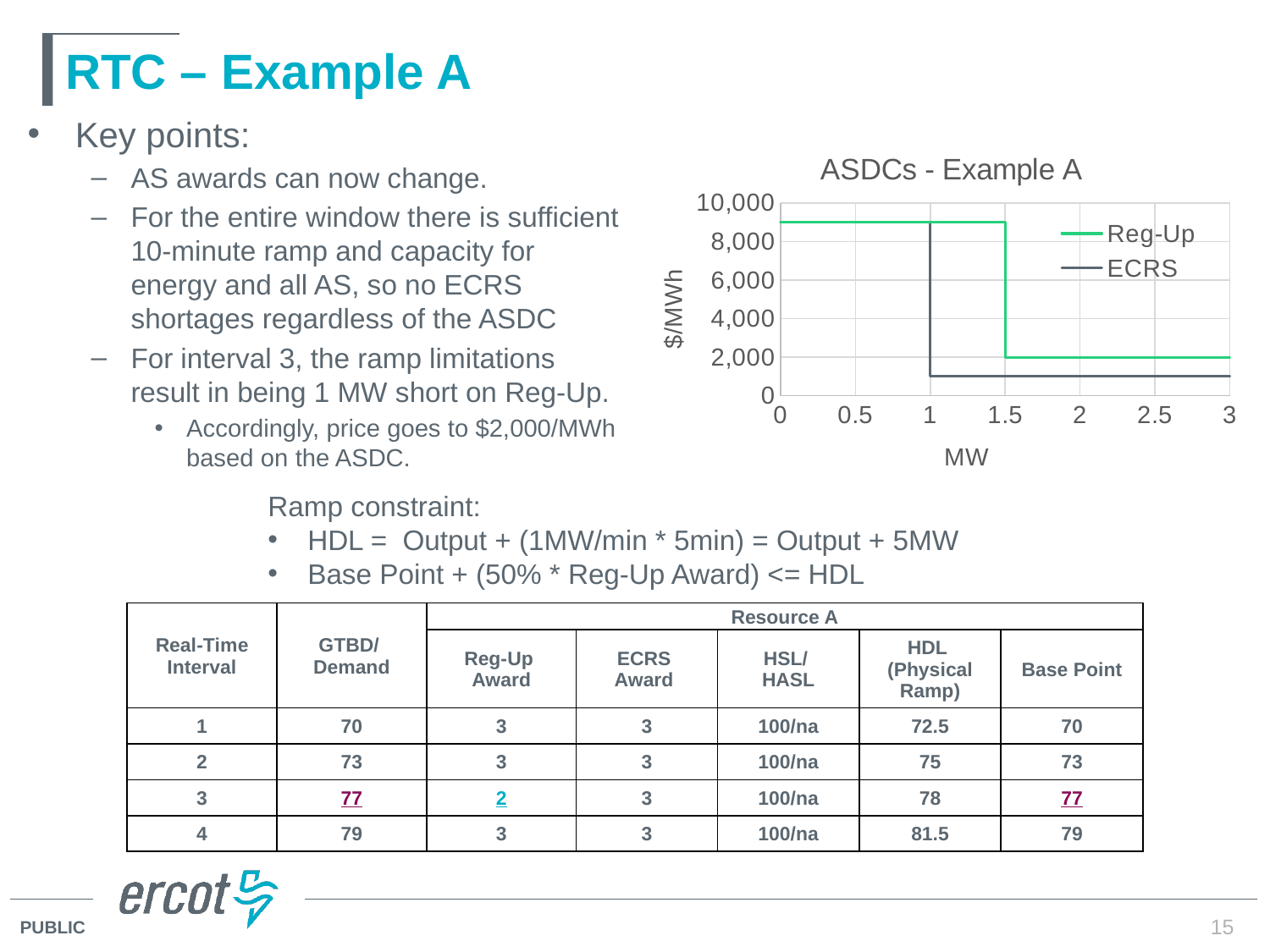
What is the Reg-Up value in $/MWh at 2 MW? 2,000 How many series does the legend of the chart list? 2 Is the ECRS value at 0.5 MW greater or less than 8,000? greater What is the title of the chart? ASDCs - Example A What are the two series named in the chart legend? Reg-Up and ECRS At what MW value does the ECRS line step down? 1 Do the Reg-Up values rise or fall as MW increases along the x axis? fall Is the ECRS value at 2 MW greater or less than 2,000? less At what MW value does the Reg-Up line step down? 1.5 Is the Reg-Up value at 0.5 MW greater or less than 8,000? greater What type of chart is shown on the slide? Line chart At 1.25 MW, which series has the higher value, Reg-Up or ECRS? Reg-Up